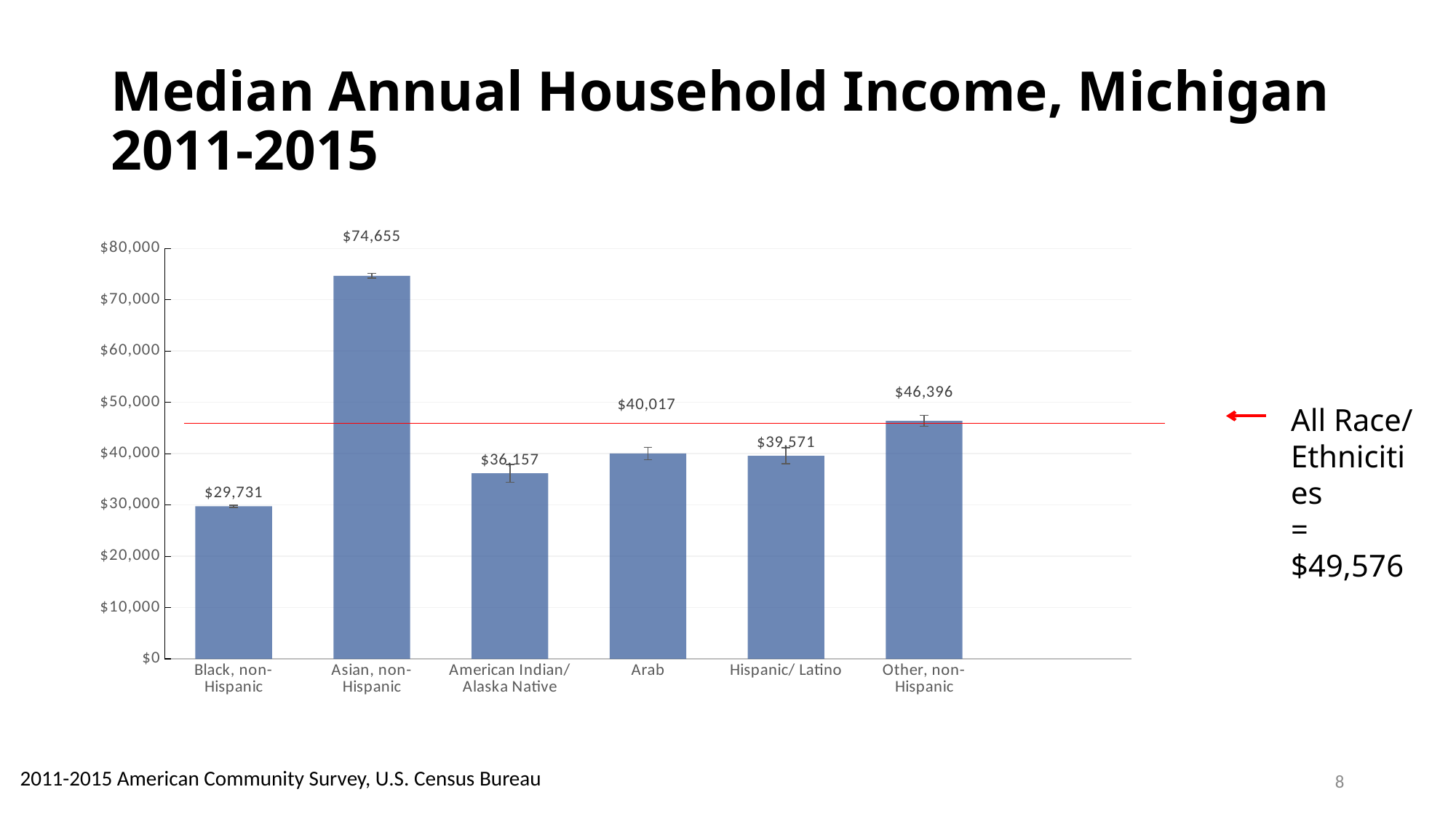
What is the median annual household income for Arab households? $40,017 How many race/ethnicity categories are shown in the chart? 6 Is the median annual household income for Other, non-Hispanic households greater or less than $40,000? greater What is the median annual household income for Asian, non-Hispanic households? $74,655 Which is larger, the median annual household income for Other, non-Hispanic or for American Indian/ Alaska Native households? Other, non-Hispanic What is the median annual household income for all race/ethnicities, as indicated by the horizontal line? $49,576 What is the median annual household income for Black, non-Hispanic households? $29,731 What is the median annual household income for Hispanic/ Latino households? $39,571 Which race/ethnicity group has the highest median annual household income? Asian, non-Hispanic What kind of chart is shown on the slide? Bar chart What is the difference between the median annual household income for Asian, non-Hispanic and Black, non-Hispanic households? $44,924 Which race/ethnicity group has the lowest median annual household income? Black, non-Hispanic